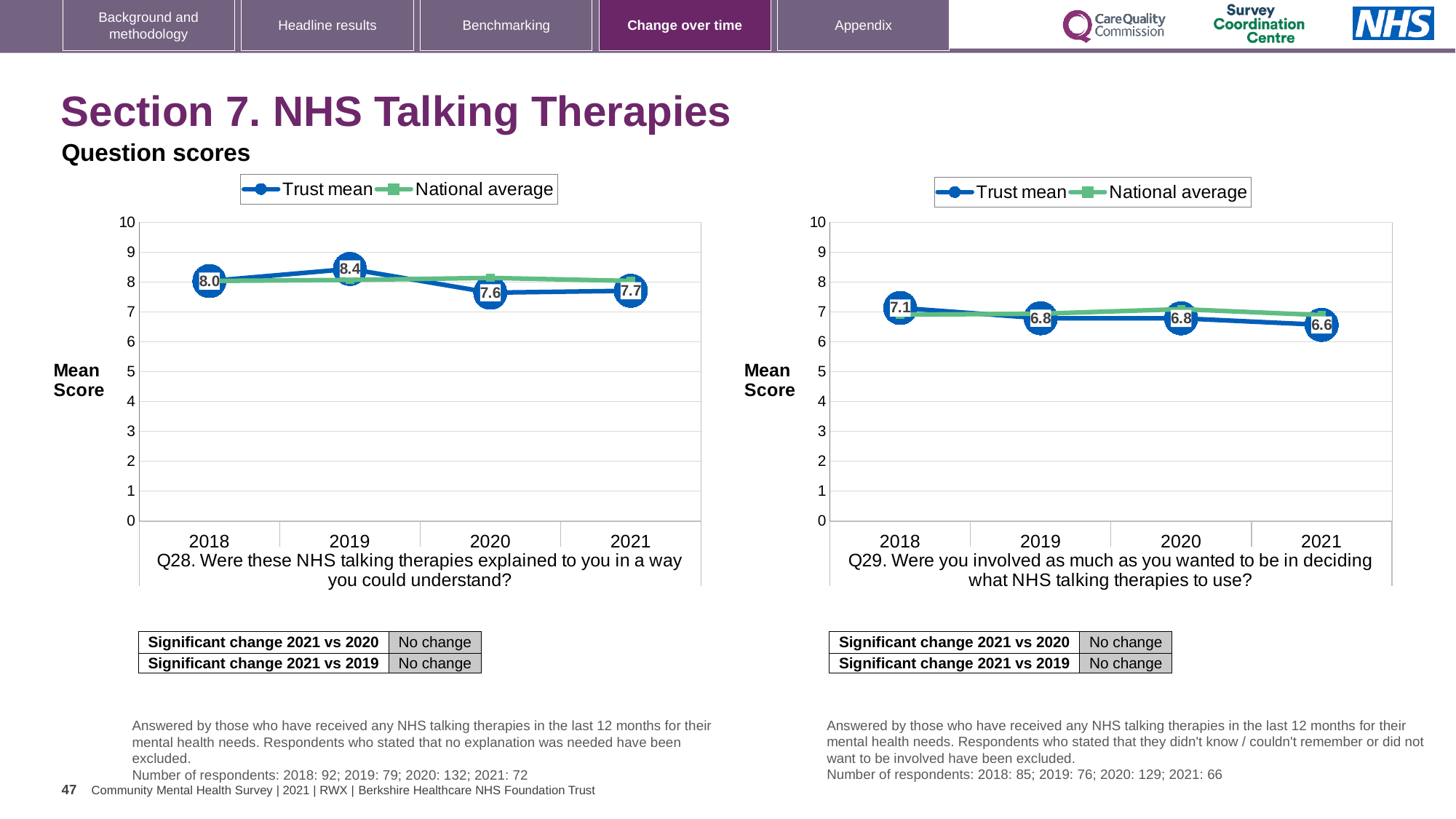
In the Q28 chart, what is the difference between the Trust mean scores for 2019 and 2020? 0.8 In the Q29 chart, what is the Trust mean score for 2021? 6.6 How many series does the legend of the Q28 chart list? 2 In the Q28 chart, which year has the highest Trust mean score? 2019 In the Q28 chart, is the Trust mean score higher in 2018 or in 2021? 2018 What kind of chart is the Q29 chart? Line chart In the Q28 chart, which year has the lowest Trust mean score? 2020 In the Q28 chart, what is the Trust mean score for 2019? 8.4 In the Q29 chart, which year has the highest Trust mean score? 2018 In the Q29 chart, is the National average value for 2018 greater or less than 8? less In the Q29 chart, what is the difference between the Trust mean scores for 2018 and 2021? 0.5 How many years are shown on the x axis of the Q29 chart? 4